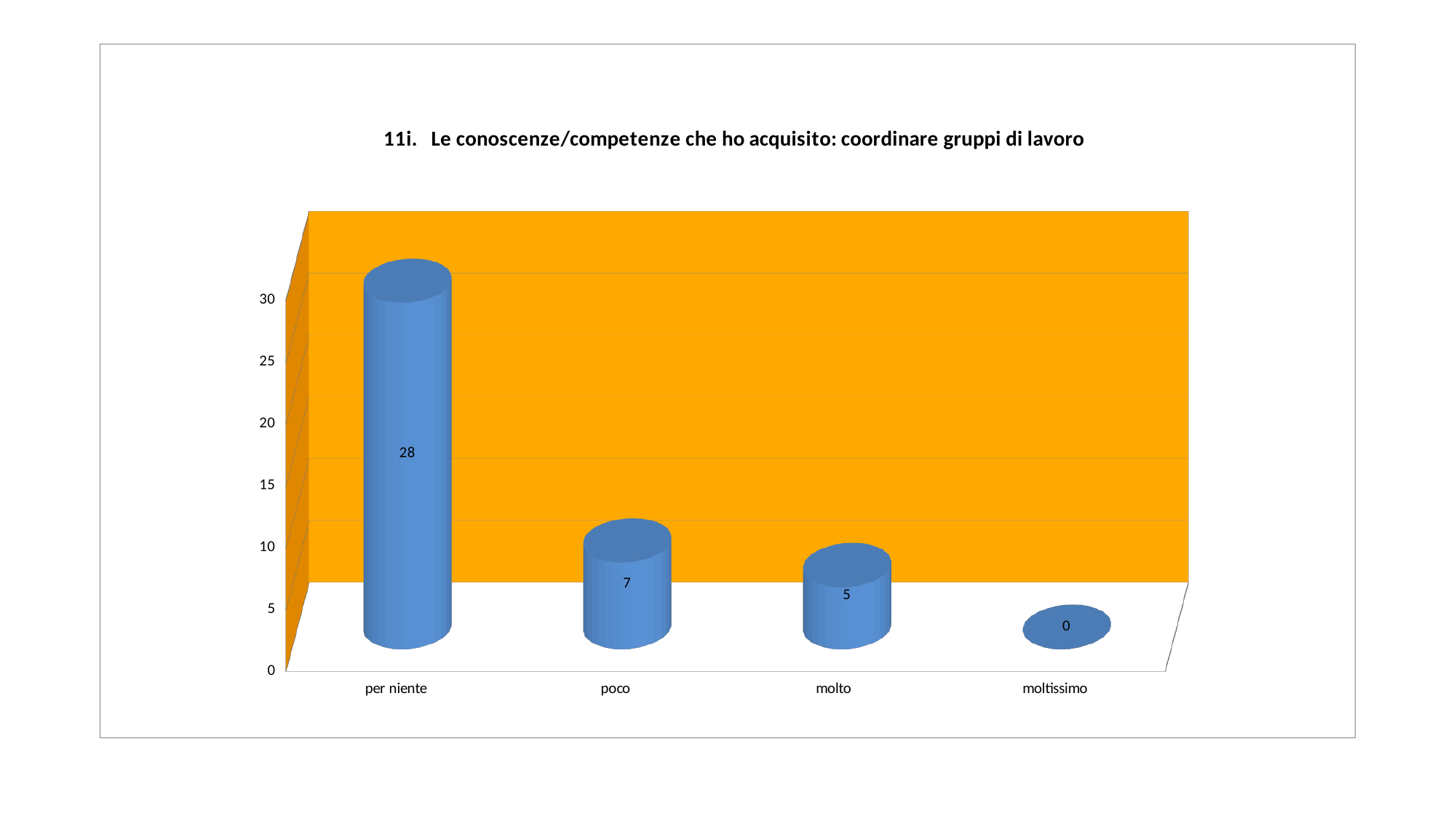
How many categories are shown on the x axis? 4 What is the value for "moltissimo"? 0 What is the value for "per niente"? 28 What is the title of the chart? 11i. Le conoscenze/competenze che ho acquisito: coordinare gruppi di lavoro Which category has the lowest value? moltissimo Which is larger, the value for "poco" or the value for "molto"? poco Which category has the highest value? per niente Is the value for "per niente" greater or less than 25? greater What is the value for "molto"? 5 What is the difference between the values for "per niente" and "poco"? 21 What kind of chart is shown on the slide? bar chart What is the value for "poco"? 7